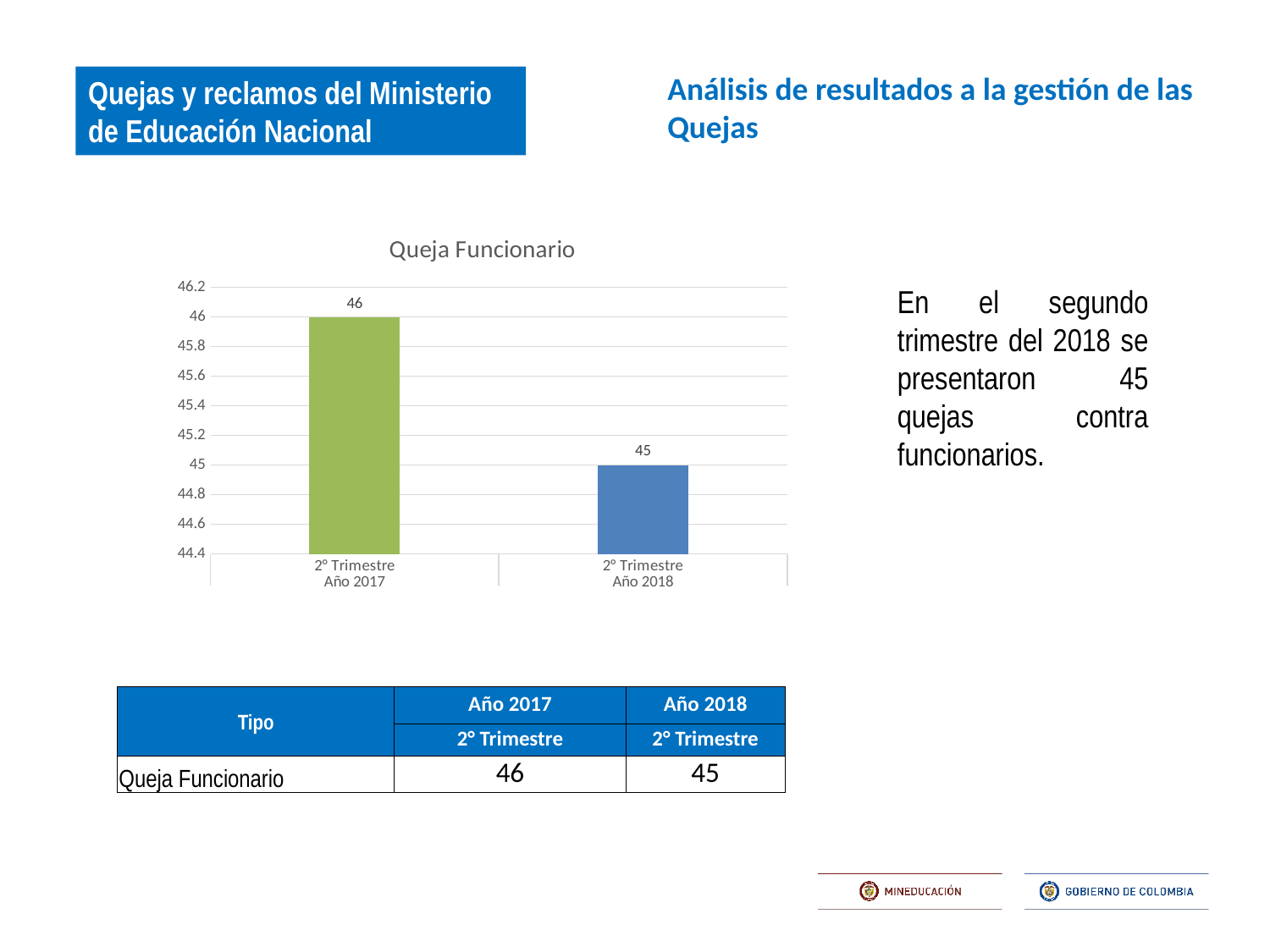
Which is larger in the Queja Funcionario chart: the value for 2° Trimestre Año 2017 or 2° Trimestre Año 2018? 2° Trimestre Año 2017 What is the title of the chart on the slide? Queja Funcionario What is the value for 2° Trimestre Año 2018 in the Queja Funcionario chart? 45 Do the values in the Queja Funcionario chart rise or fall from 2° Trimestre Año 2017 to 2° Trimestre Año 2018? fall What is the difference between the 2° Trimestre Año 2017 and 2° Trimestre Año 2018 values in the Queja Funcionario chart? 1 What is the value for 2° Trimestre Año 2017 in the Queja Funcionario chart? 46 What colour is the bar for 2° Trimestre Año 2017 in the Queja Funcionario chart? green Which category has the lowest value in the Queja Funcionario chart? 2° Trimestre Año 2018 How many categories are shown in the Queja Funcionario chart? 2 What kind of chart is the Queja Funcionario chart? bar chart Which category has the highest value in the Queja Funcionario chart? 2° Trimestre Año 2017 Is the value for 2° Trimestre Año 2018 in the Queja Funcionario chart greater or less than 45.4? less